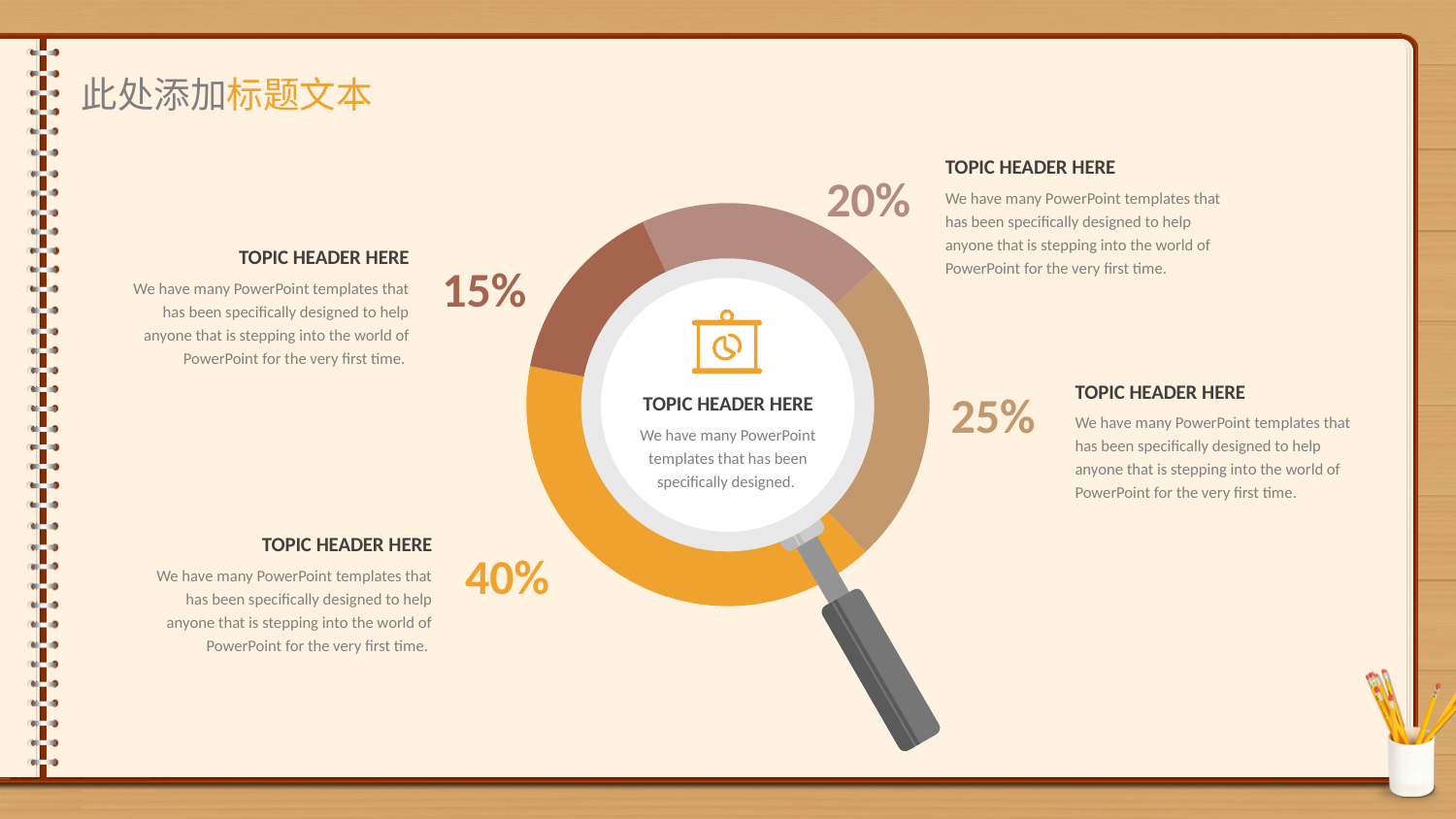
What is the smallest percentage shown on the donut chart? 15% What percentage is labelled on the orange segment of the donut chart? 40% Which is larger, the 25% segment or the 20% segment of the donut chart? The 25% segment What percentage is labelled on the segment at the top of the donut chart? 20% What is the largest percentage shown on the donut chart? 40% What is the difference between the largest and smallest percentages on the donut chart? 25 percentage points How many segments does the donut chart have? 4 What percentage is labelled on the segment at the right side of the donut chart? 25% What percentage is labelled on the dark brown segment at the upper left of the donut chart? 15% What text appears in the centre of the donut chart as the header? TOPIC HEADER HERE What do the four percentages on the donut chart add up to? 100% What kind of chart is shown on the slide? Donut (pie) chart